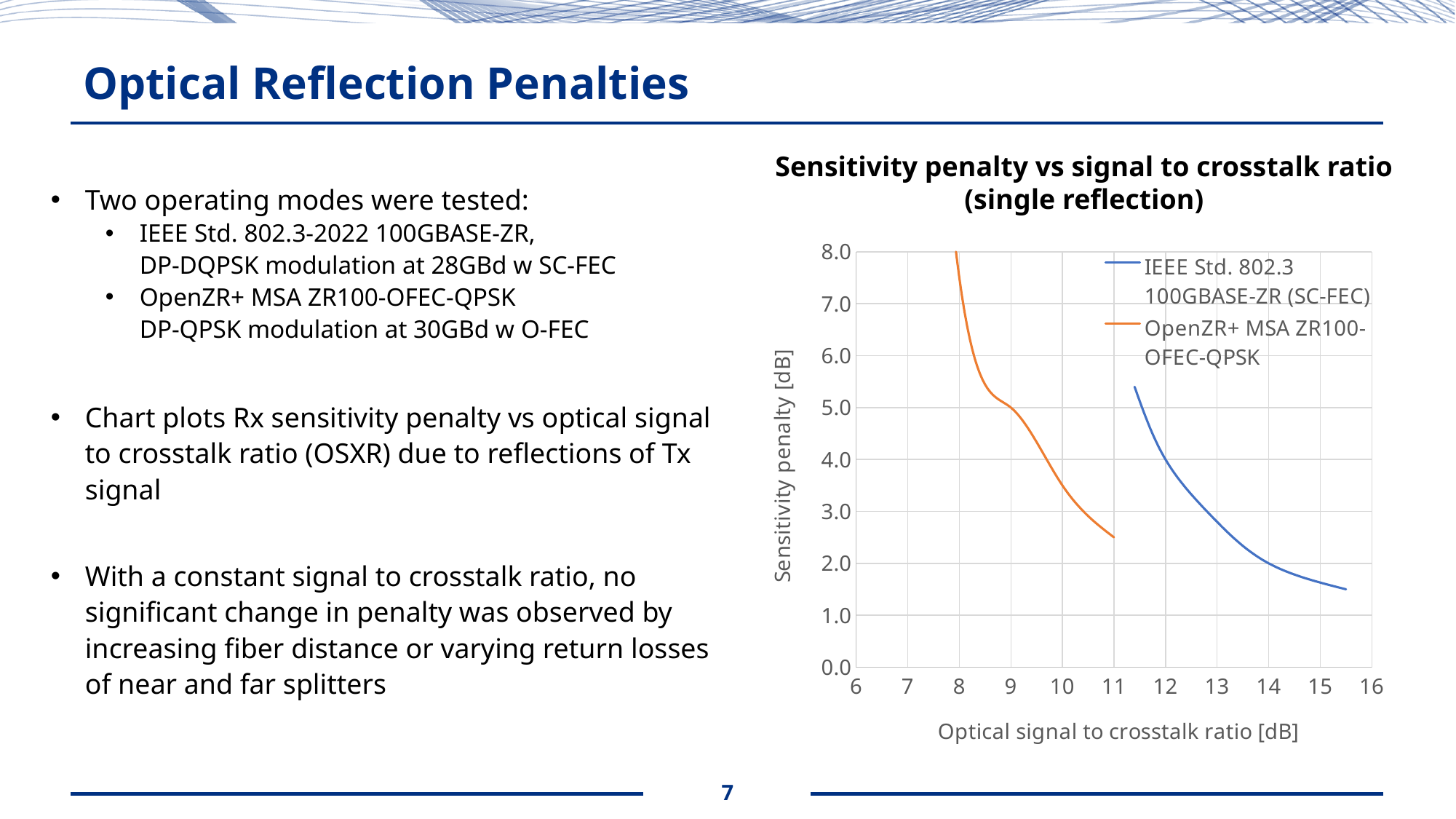
Is the sensitivity penalty for the OpenZR+ MSA ZR100-OFEC-QPSK series at an optical signal to crosstalk ratio of 8 dB greater or less than 7.0? greater Is the sensitivity penalty for the IEEE Std. 802.3 100GBASE-ZR (SC-FEC) series at an optical signal to crosstalk ratio of 15 dB greater or less than 2.0? less Is the sensitivity penalty for the OpenZR+ MSA ZR100-OFEC-QPSK series at an optical signal to crosstalk ratio of 11 dB greater or less than 3.0? less Does the sensitivity penalty for the IEEE Std. 802.3 100GBASE-ZR (SC-FEC) series rise or fall as the optical signal to crosstalk ratio increases? Fall What is the label of the y axis of the chart? Sensitivity penalty [dB] Which series extends to the higher optical signal to crosstalk ratio on the chart? IEEE Std. 802.3 100GBASE-ZR (SC-FEC) How many series does the legend of the chart list? 2 What is the title of the chart? Sensitivity penalty vs signal to crosstalk ratio (single reflection) Which series reaches the higher sensitivity penalty on the chart? OpenZR+ MSA ZR100-OFEC-QPSK What kind of chart is shown on the slide? Line chart Does the sensitivity penalty for the OpenZR+ MSA ZR100-OFEC-QPSK series rise or fall as the optical signal to crosstalk ratio increases? Fall